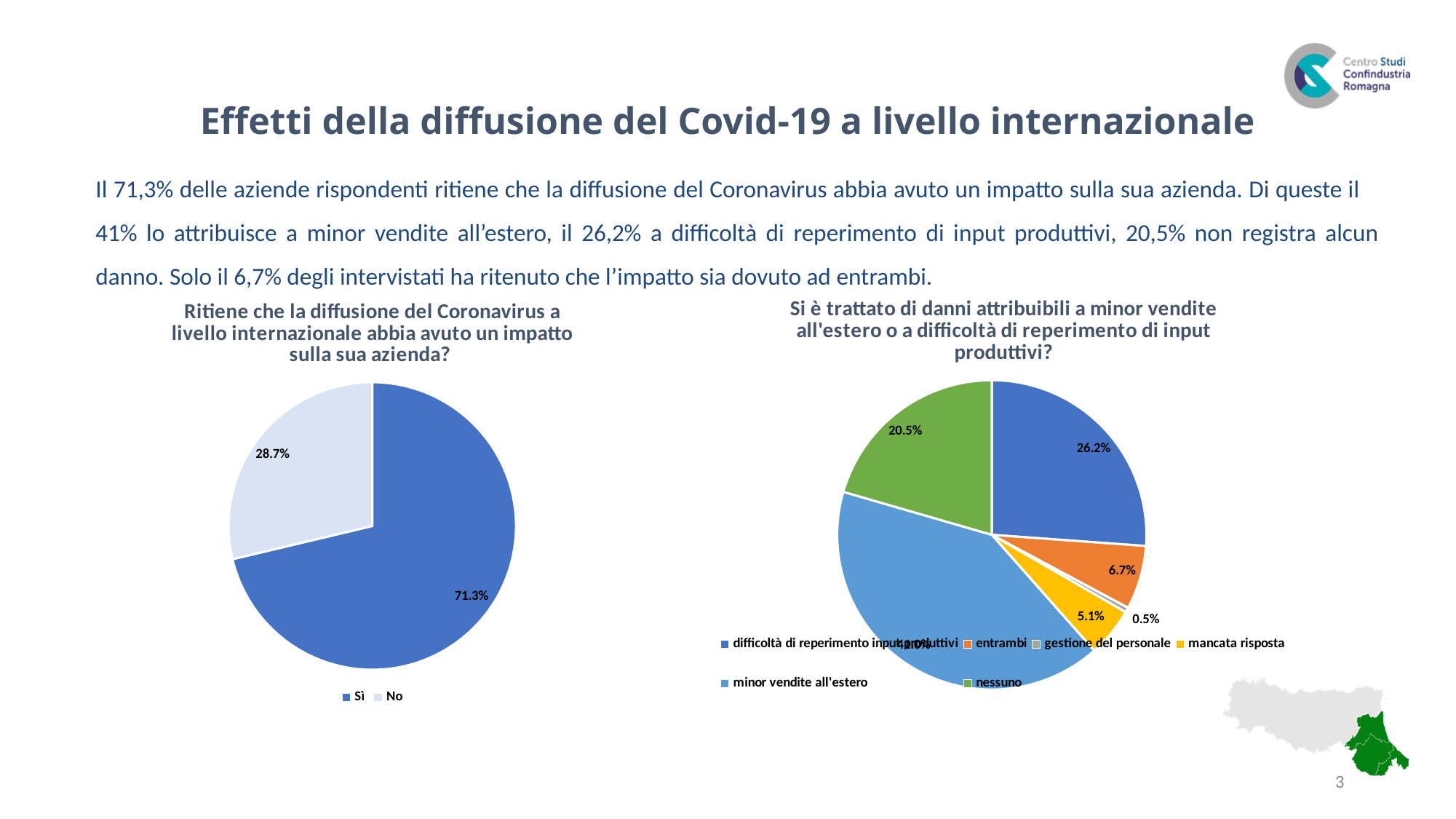
How many categories does the legend of the right pie chart list? 6 In the left pie chart, what is the difference between the 'Sì' and 'No' shares? 42.6 percentage points In the right pie chart, which category has the largest slice? minor vendite all'estero In the left pie chart, what share of respondents answered 'Sì'? 71.3% In the right pie chart, 'Si è trattato di danni attribuibili a minor vendite all'estero o a difficoltà di reperimento di input produttivi?', what share is 'difficoltà di reperimento input produttivi'? 26.2% What kind of chart is the left chart, 'Ritiene che la diffusione del Coronavirus a livello internazionale abbia avuto un impatto sulla sua azienda?'? Pie chart In the right pie chart, what share is 'nessuno'? 20.5% In the left pie chart, what share of respondents answered 'No'? 28.7% In the left pie chart, which slice is larger, 'Sì' or 'No'? Sì In the right pie chart, what share is 'entrambi'? 6.7% In the right pie chart, which category has the smallest slice? gestione del personale How many entries does the legend of the left pie chart list? 2